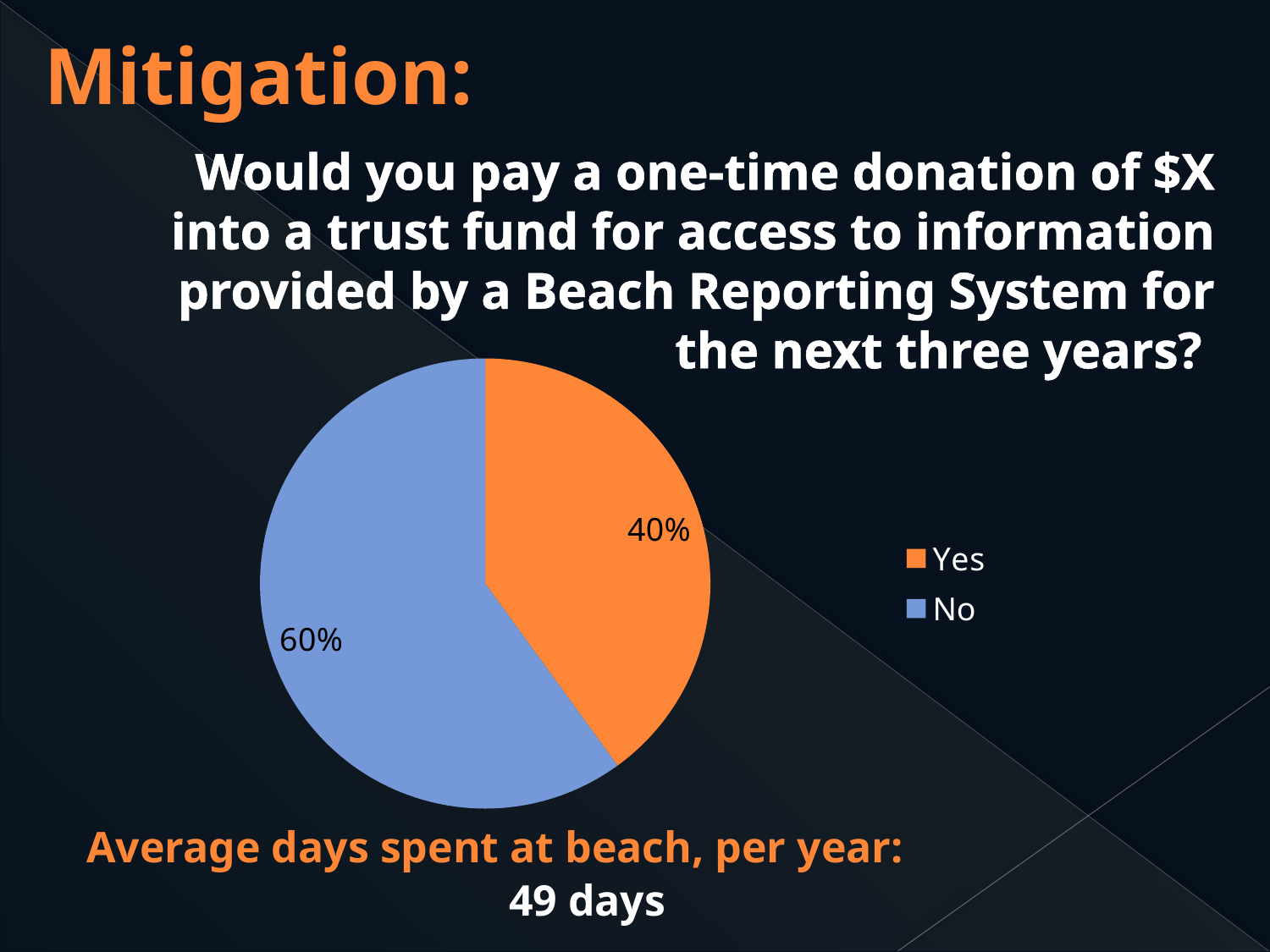
What colour is the Yes slice? orange What is the difference in percentage points between the No and Yes slices? 20% How many slices does the pie chart have? 2 What percentage of respondents answered No? 60% What colour is the No slice? blue What share of the pie does the Yes slice represent? 40% Which response has the largest share of the pie? No How many entries does the legend list? 2 What percentage of respondents answered Yes? 40% What kind of chart is shown on the slide? pie chart Which slice is larger, Yes or No? No Which response has the smallest share of the pie? Yes